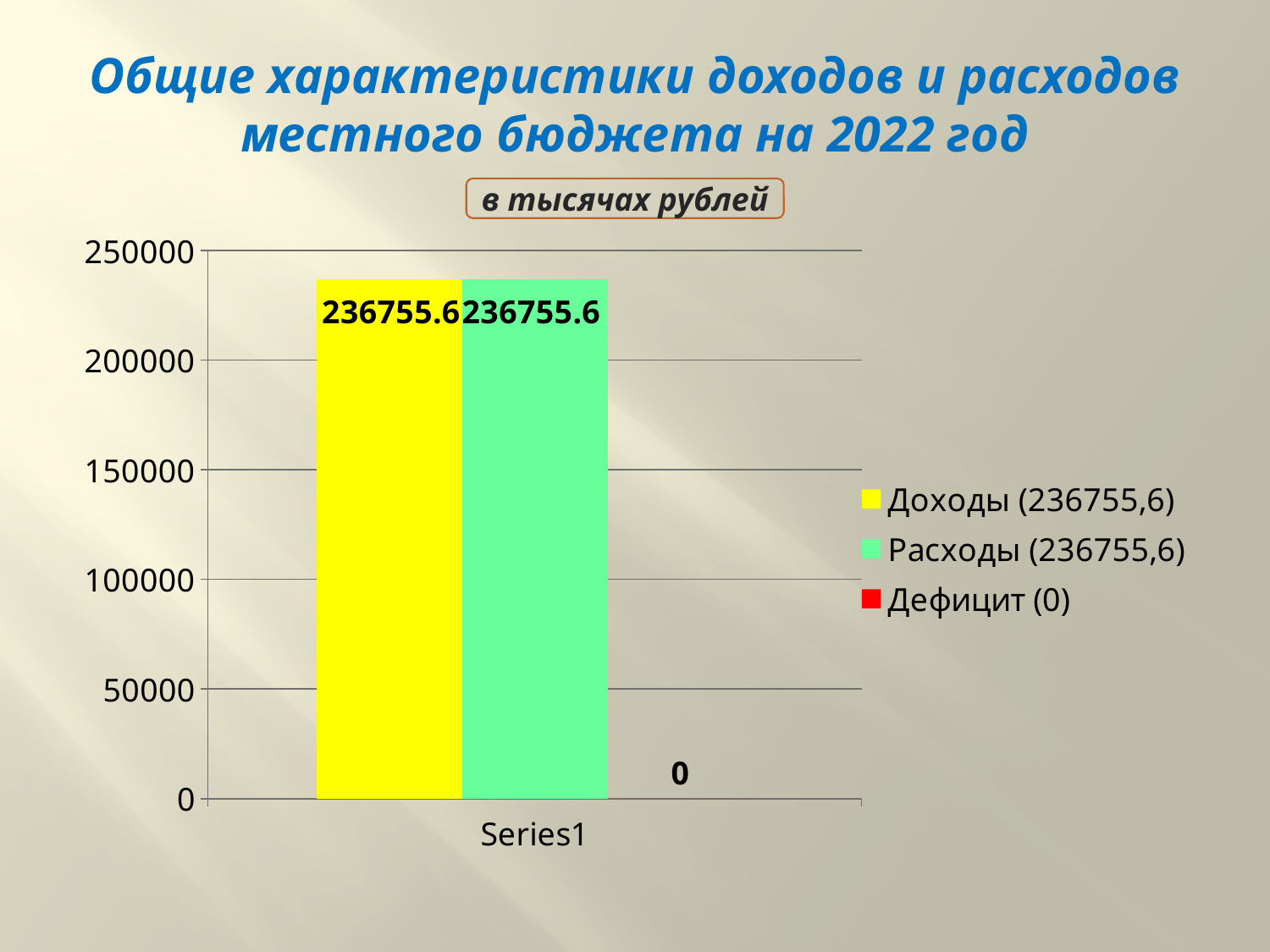
What is the value of the Доходы bar? 236755.6 Which series has the lowest value? Дефицит What is the value of the Расходы bar? 236755.6 Which is larger, the Расходы value or the Дефицит value? Расходы Is the value for Расходы greater or less than 250000? less Is the value for Доходы greater or less than 200000? greater What colour is the Доходы bar? yellow How many series does the legend list? 3 What is the difference between the Доходы and Расходы values? 0 What is the value shown for Дефицит? 0 What type of chart is shown on the slide? bar chart What unit is stated for the chart values? в тысячах рублей